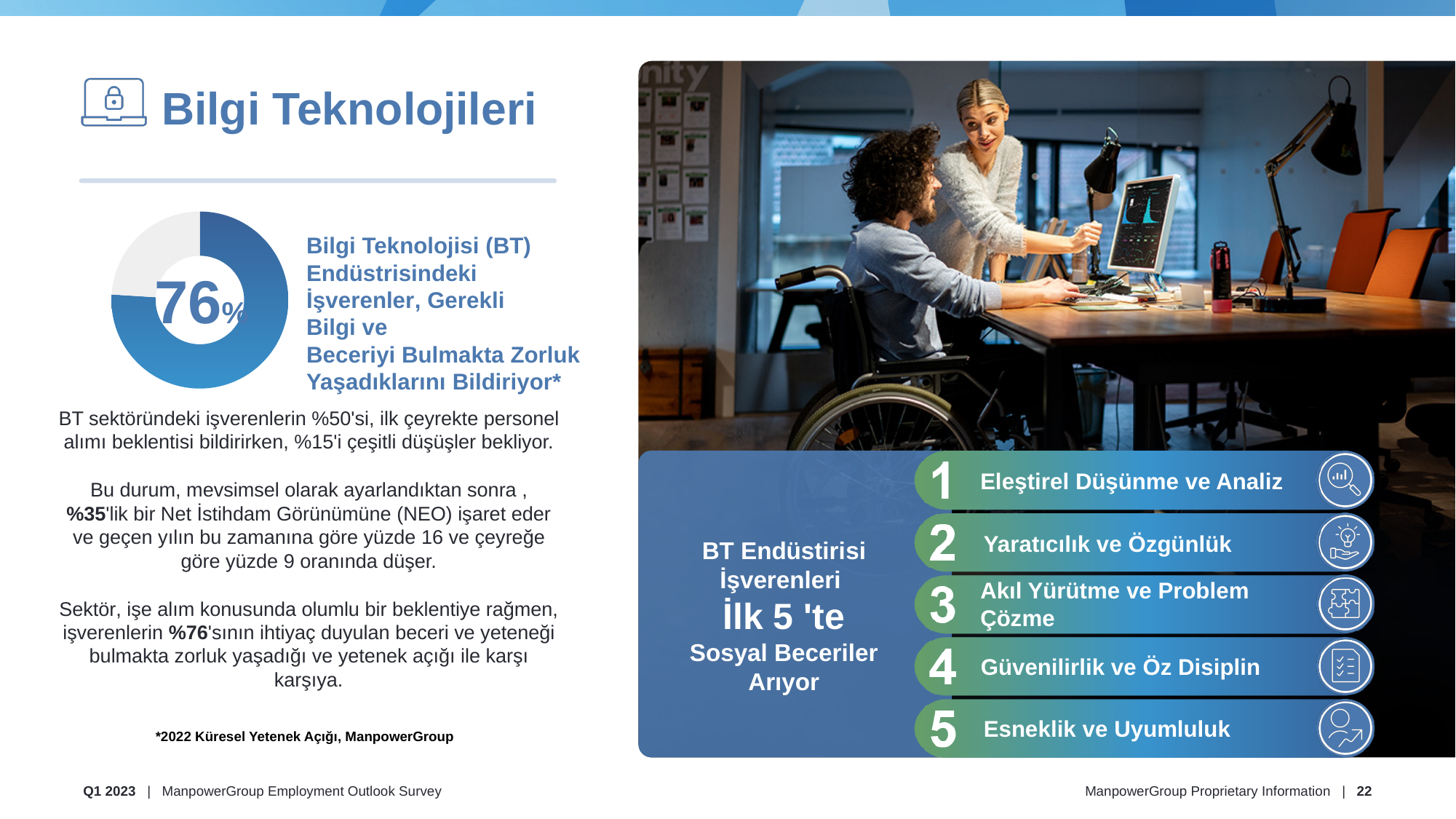
What kind of chart is shown on the left of the slide next to the text about BT employers? pie chart (donut) How many slices does the donut chart have? 2 What percentage is printed in the centre of the donut chart? 76% According to the text beside the donut chart, what does the 76% represent? BT employers reporting difficulty finding required knowledge and skills What colour is the larger slice of the donut chart? blue Is the value shown in the donut chart greater or less than 50%? greater What share of the donut chart is filled in blue? 76% Which slice of the donut chart is larger, the blue one or the grey one? the blue one